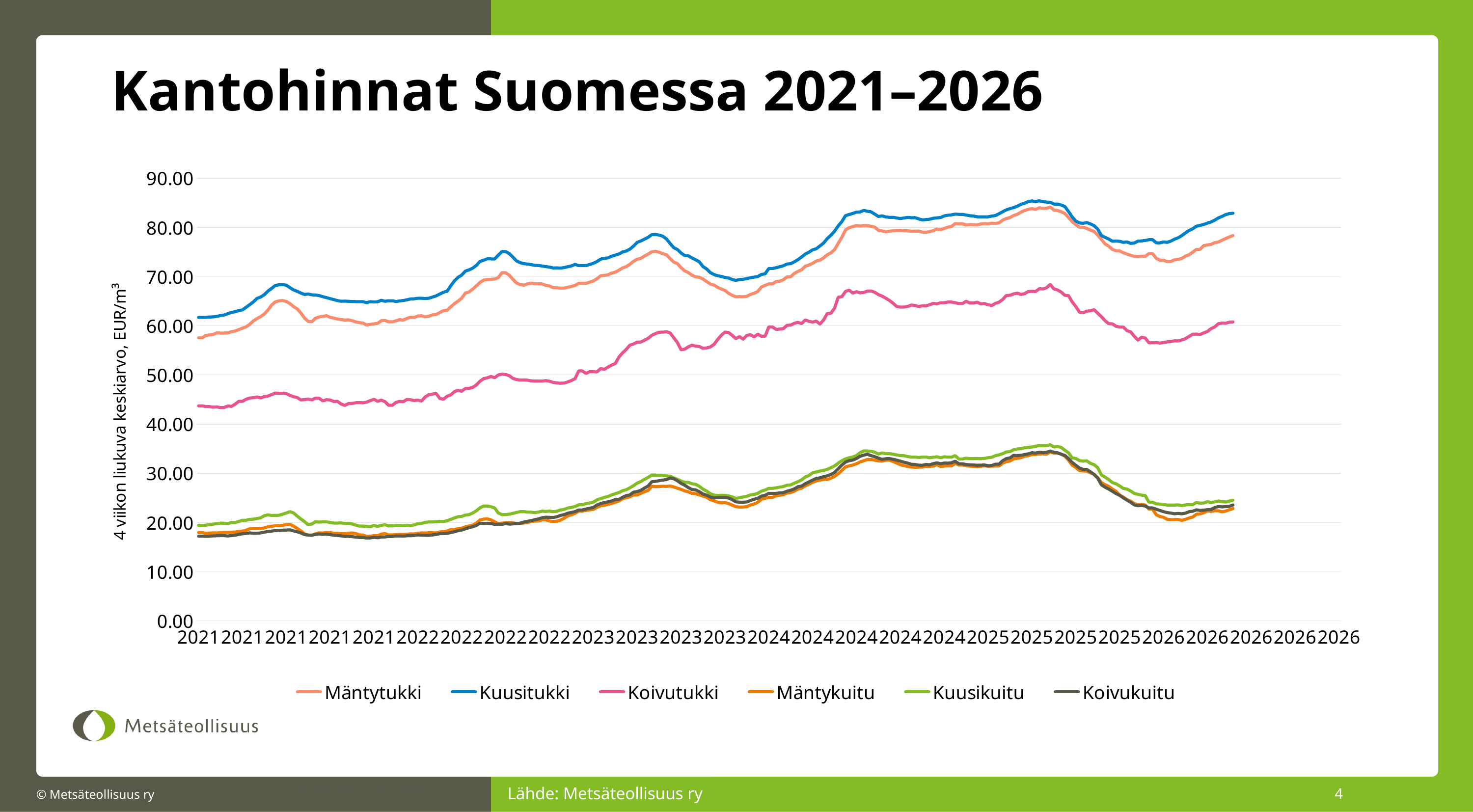
Is the highest value reached by Mäntytukki greater or less than 80? greater Which series has the highest values across the whole period? Kuusitukki How many series does the legend list? 6 At the end of the period in 2026, which is higher, Kuusitukki or Mäntytukki? Kuusitukki What is the label of the vertical axis? 4 viikon liukuva keskiarvo, EUR/m³ Is the highest value reached by Kuusitukki greater or less than 80? greater Is the value for Koivutukki at the start of 2021 greater or less than 50? less What is the title of the chart? Kantohinnat Suomessa 2021–2026 What kind of chart is shown on the slide? line chart Overall, does the Koivutukki series rise or fall from 2021 to 2026? rise Which series is higher throughout the period, Koivutukki or Kuusikuitu? Koivutukki